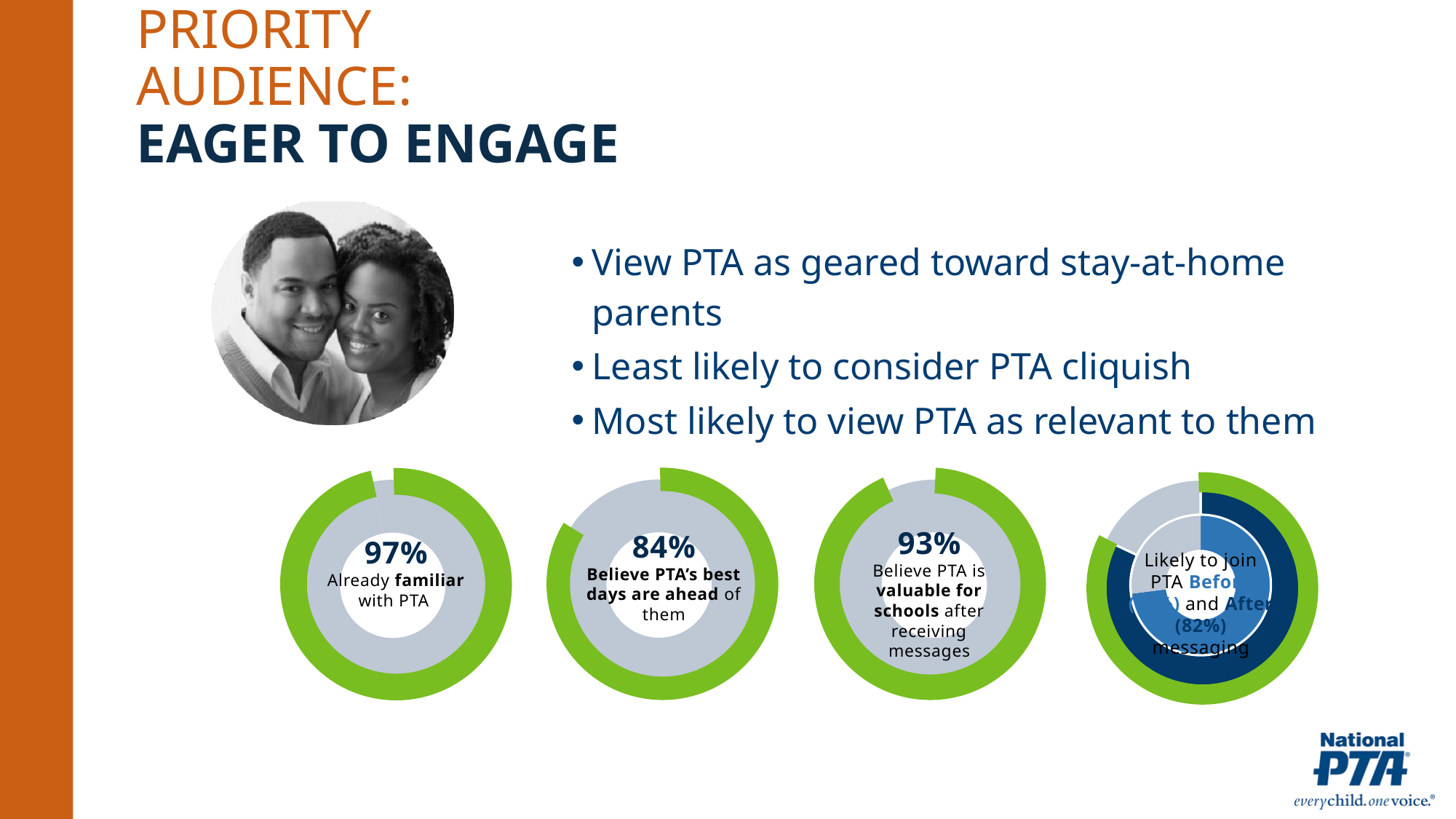
Which of the first three donut charts shows the highest percentage? Already familiar with PTA (97%) What type of chart is used to display the percentages at the bottom of the slide? Donut (pie) chart What is the difference between the percentage already familiar with PTA and the percentage who believe PTA is valuable for schools after receiving messages? 4 percentage points What is the difference between the percentage already familiar with PTA and the percentage who believe PTA's best days are ahead? 13 percentage points According to the third donut chart, what percentage believe PTA is valuable for schools after receiving messages? 93% Which is larger: the percentage who believe PTA is valuable for schools after receiving messages, or the percentage who believe PTA's best days are ahead? Valuable for schools after receiving messages (93%) According to the second donut chart, what percentage believe PTA's best days are ahead of them? 84% How many donut charts are shown on the slide? 4 What colour is used for the filled portion of the first three donut charts? Green Which of the first three donut charts shows the lowest percentage? Believe PTA's best days are ahead of them (84%) What percentage of the priority audience is already familiar with PTA, according to the first donut chart? 97% In the fourth donut chart, what percentage are likely to join PTA after messaging? 82%